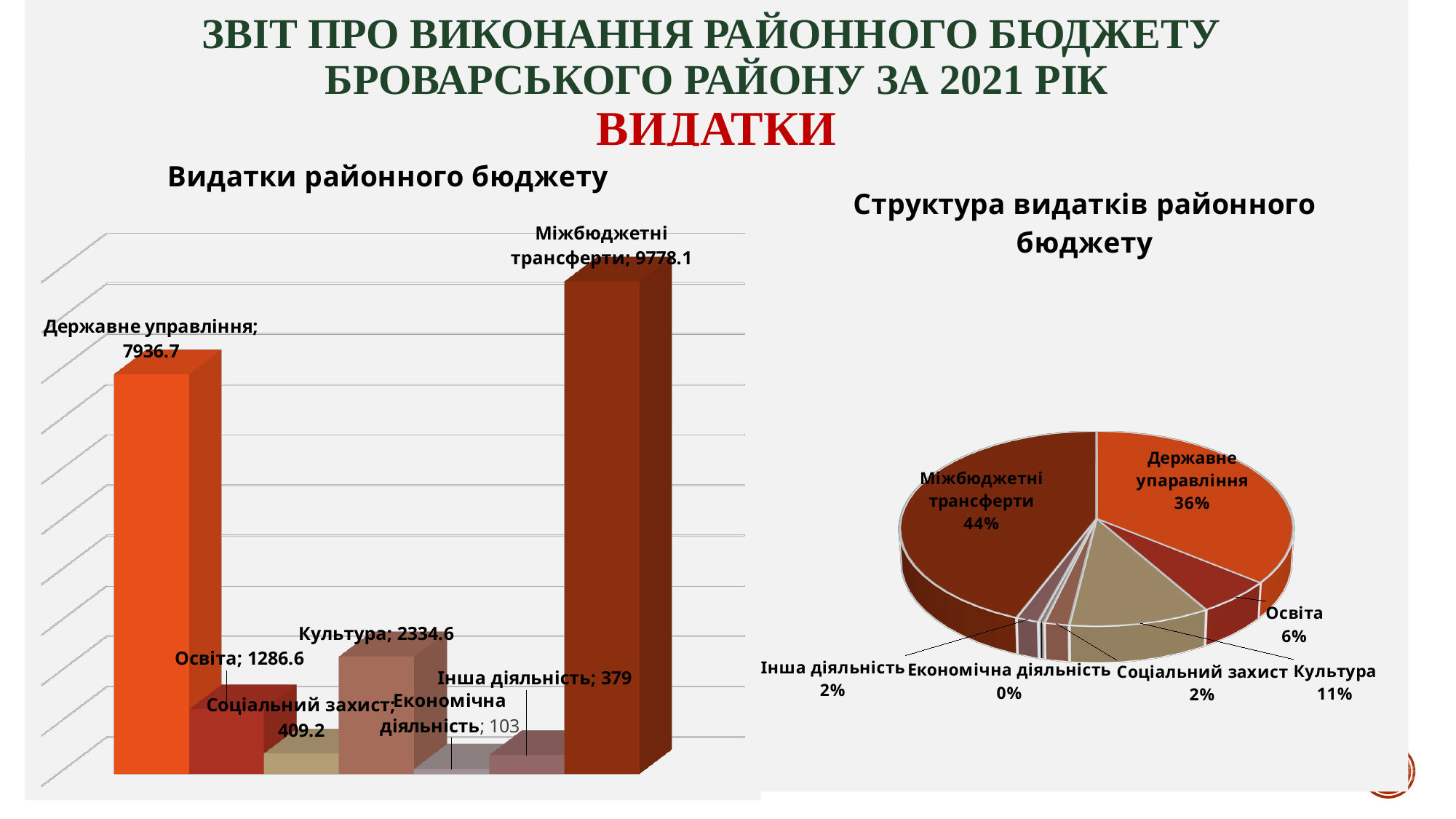
In the bar chart 'Видатки районного бюджету', which is larger: Освіта or Соціальний захист? Освіта What type of chart is 'Видатки районного бюджету'? Bar chart In the pie chart 'Структура видатків районного бюджету', what share does Міжбюджетні трансферти have? 44% In the bar chart 'Видатки районного бюджету', which category has the lowest value? Економічна діяльність In the pie chart 'Структура видатків районного бюджету', what share does Культура have? 11% In the bar chart 'Видатки районного бюджету', what is the difference between Міжбюджетні трансферти and Державне управління? 1841.4 What type of chart is 'Структура видатків районного бюджету'? Pie chart In the bar chart 'Видатки районного бюджету', which category has the highest value? Міжбюджетні трансферти How many categories are shown in the bar chart 'Видатки районного бюджету'? 7 In the bar chart 'Видатки районного бюджету', what is the value for Економічна діяльність? 103 In the bar chart 'Видатки районного бюджету', what is the value for Культура? 2334.6 In the bar chart 'Видатки районного бюджету', what is the value for Міжбюджетні трансферти? 9778.1